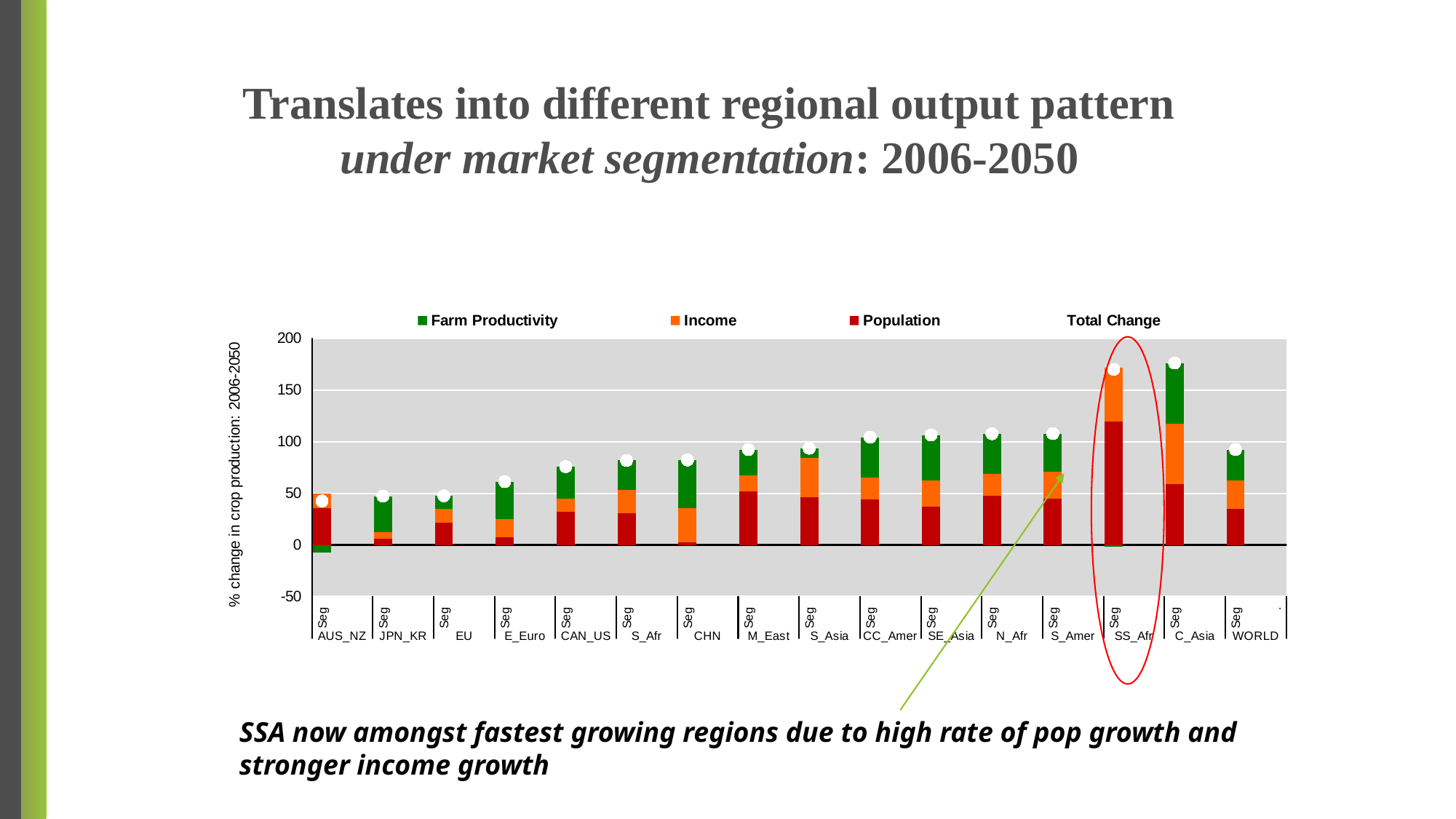
How many entries does the chart's legend list? 4 Which has the larger Total Change, SS_Afr or WORLD? SS_Afr Is the Total Change value for SS_Afr greater or less than 150? greater Which region has the larger Population contribution, SS_Afr or C_Asia? SS_Afr Is the Total Change value for WORLD greater or less than 100? less Is the Population contribution for SS_Afr greater or less than 100? greater What kind of chart is shown on the slide? Stacked bar chart How many regions (categories) are shown along the x axis of the chart? 16 Do the Total Change values generally rise or fall moving from AUS_NZ to C_Asia along the x axis? rise What is the label on the chart's vertical axis? % change in crop production: 2006-2050